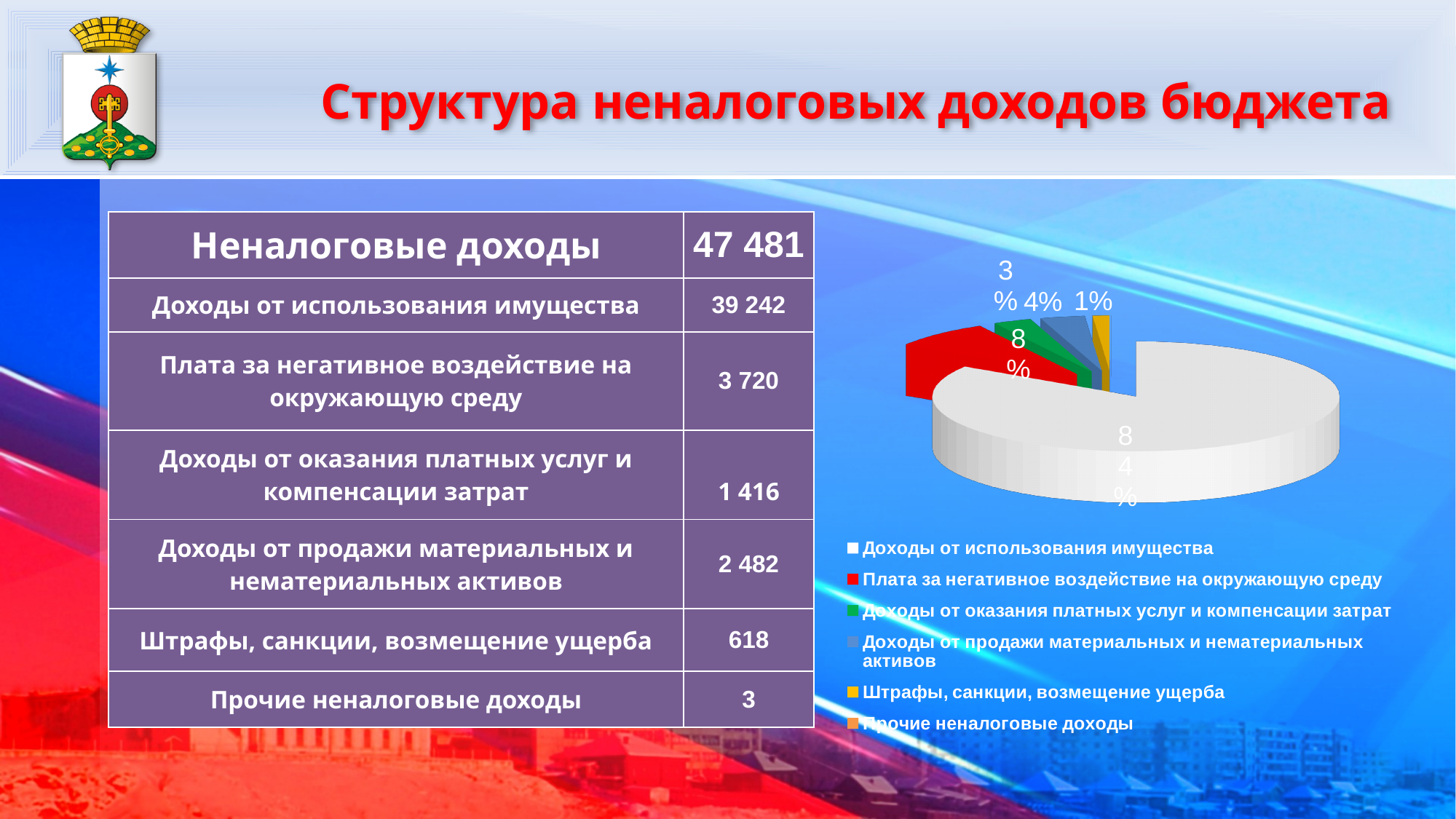
What kind of chart is shown on the slide? pie chart What share of the pie does "Доходы от продажи материальных и нематериальных активов" take? 4% What share of the pie does "Доходы от оказания платных услуг и компенсации затрат" take? 3% Which labelled slice of the pie is the smallest? Штрафы, санкции, возмещение ущерба What share of the pie does "Штрафы, санкции, возмещение ущерба" take? 1% What colour is the slice for "Плата за негативное воздействие на окружающую среду"? red What share of the pie does "Доходы от использования имущества" take? 84% How many entries does the chart legend list? 6 What is the difference in percentage points between the slices for "Доходы от использования имущества" and "Плата за негативное воздействие на окружающую среду"? 76 What share of the pie does "Плата за негативное воздействие на окружающую среду" take? 8% Which category has the largest slice of the pie? Доходы от использования имущества Which slice is larger: "Доходы от продажи материальных и нематериальных активов" or "Доходы от оказания платных услуг и компенсации затрат"? Доходы от продажи материальных и нематериальных активов